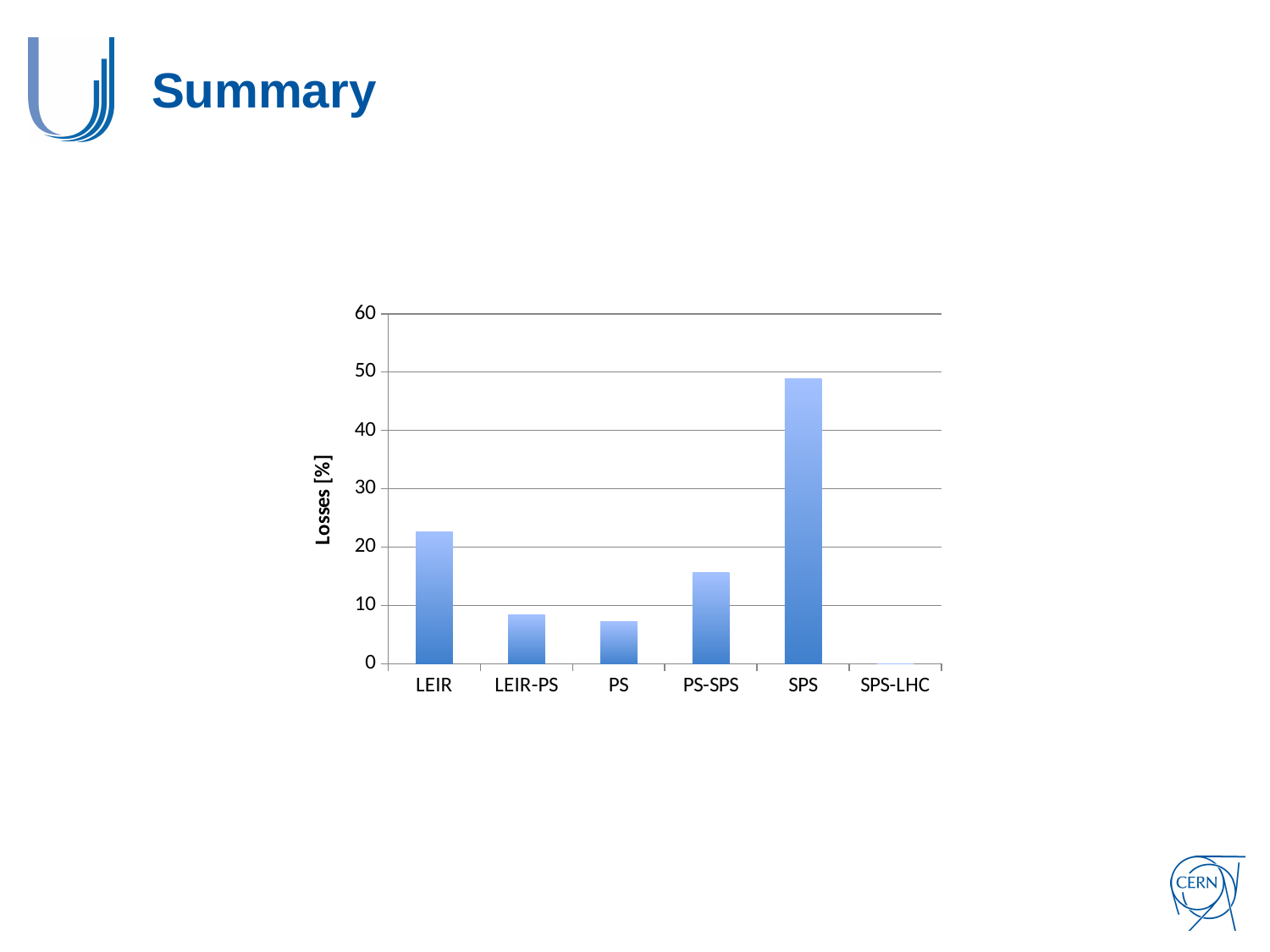
Is the value for SPS greater or less than 40? greater What kind of chart is shown on the slide? bar chart How many categories are shown on the x axis of the chart? 6 What is the label of the y axis of the chart? Losses [%] Which is larger, the value for SPS or the value for LEIR? SPS Which is larger, the value for LEIR or the value for PS-SPS? LEIR Is the value for PS greater or less than 10? less Is the value for LEIR greater or less than 30? less Which category has the lowest losses? SPS-LHC Which category has the highest losses? SPS